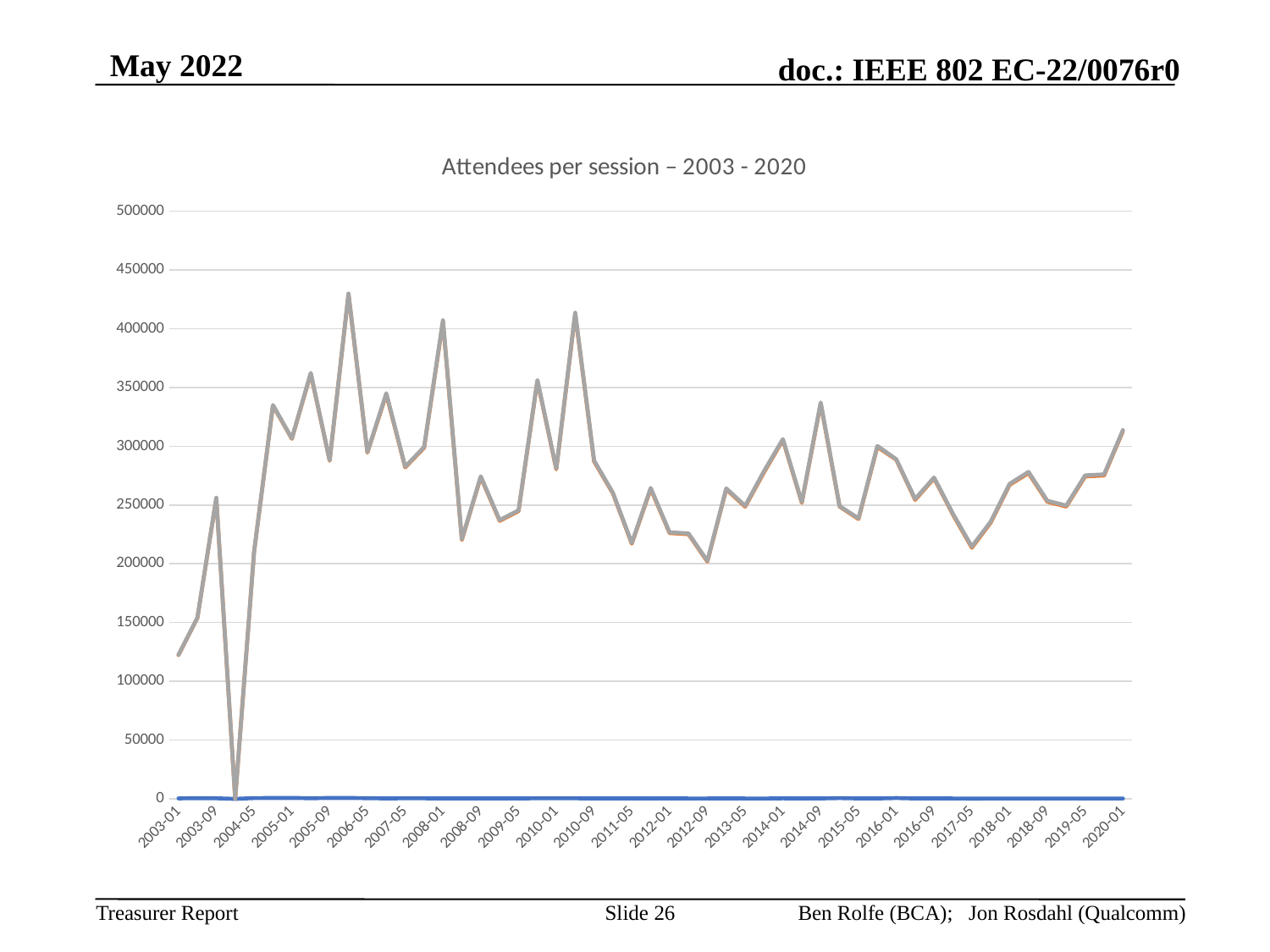
Is the value for 2020-01 greater or less than 250000? greater Is the value for 2003-01 greater or less than 100000? greater Which has the larger value, 2003-09 or 2012-09? 2003-09 What kind of chart is shown on the slide? line chart Is the value for 2017-05 greater or less than 250000? less What is the highest value shown on the vertical axis of the chart? 500000 Do the values rise or fall from 2003-01 to 2003-09? rise Do the values rise or fall from 2012-01 to 2012-09? fall What is the title of the chart? Attendees per session – 2003 - 2020 Which has the larger value, 2003-01 or 2020-01? 2020-01